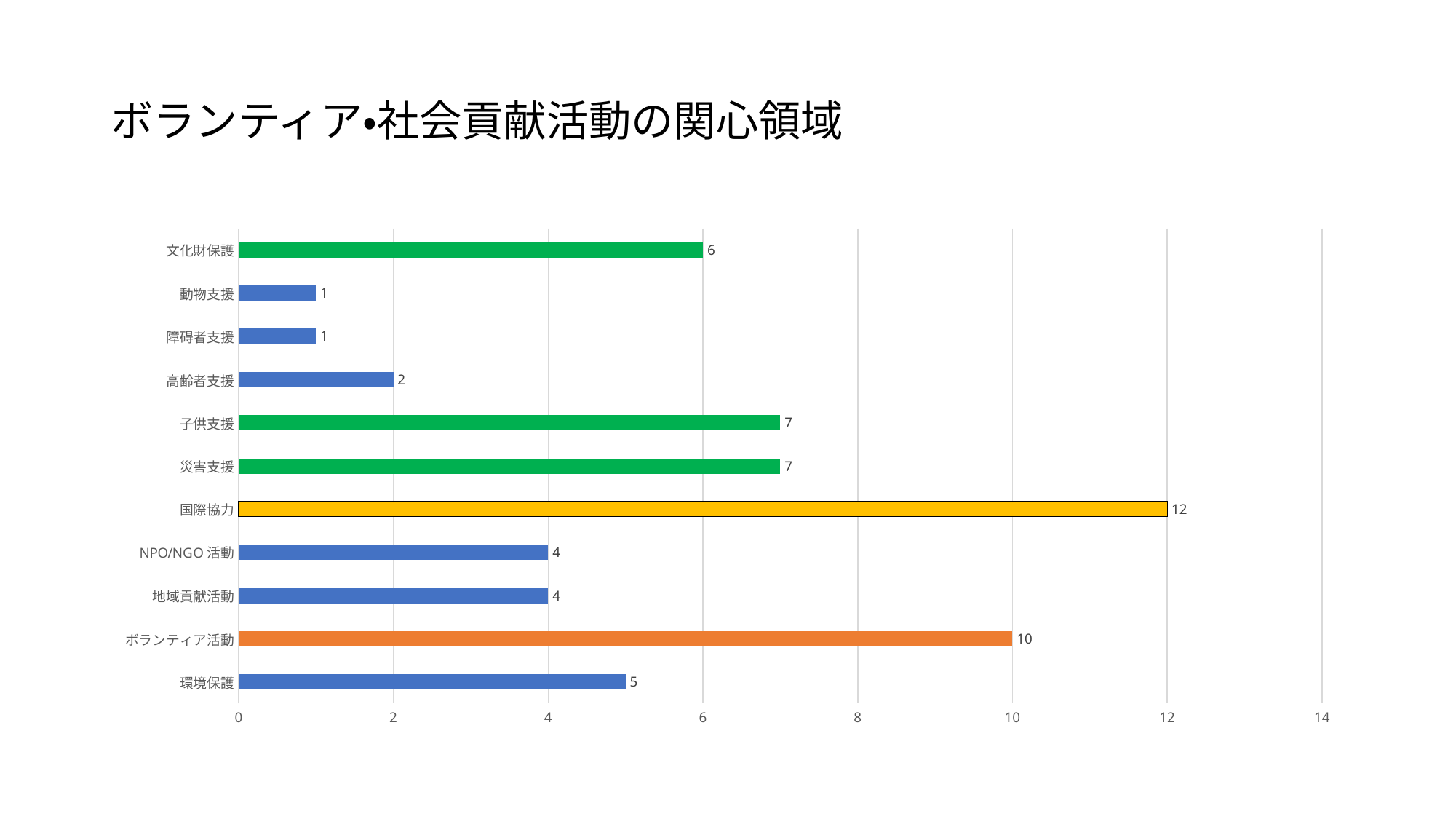
What is the difference between the values for 国際協力 and ボランティア活動? 2 What is the value for ボランティア活動? 10 Which is larger, the value for 子供支援 or the value for 高齢者支援? 子供支援 How many categories are shown in the chart? 11 What is the difference between the values for 文化財保護 and 環境保護? 1 What is the value for 環境保護? 5 What is the value for 国際協力? 12 Is the value for 災害支援 greater or less than 6? greater What is the title of the chart on the slide? ボランティア•社会貢献活動の関心領域 What is the value for 文化財保護? 6 Which category has the highest value? 国際協力 What kind of chart is shown on the slide? Bar chart